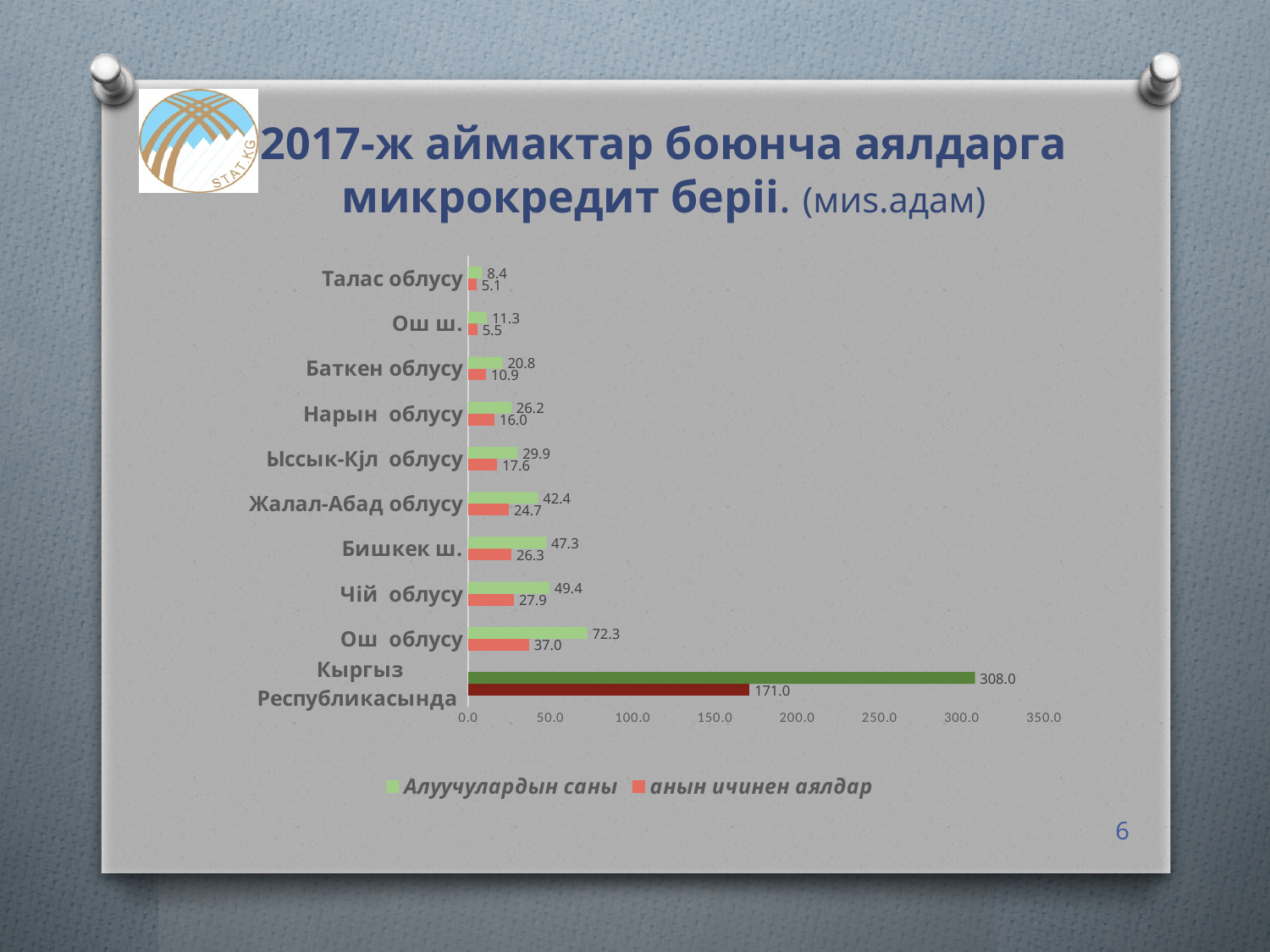
Which category has the lowest value of анын ичинен аялдар? Талас облусу What is the value of анын ичинен аялдар for Бишкек ш.? 26.3 Excluding Кыргыз Республикасында, which region has the highest value of Алуучулардын саны? Ош облусу What kind of chart is shown on the slide? bar chart How many series does the legend list? 2 What is the value of Алуучулардын саны for Ош облусу? 72.3 What is the value of Алуучулардын саны for Кыргыз Республикасында? 308.0 How many categories are shown on the chart? 10 What is the value of анын ичинен аялдар for Талас облусу? 5.1 Which is larger: Алуучулардын саны for Жалал-Абад облусу or for Баткен облусу? Жалал-Абад облусу What is the difference between Алуучулардын саны and анын ичинен аялдар for Кыргыз Республикасында? 137.0 Is the value of Алуучулардын саны for Кыргыз Республикасында greater or less than 300.0? greater